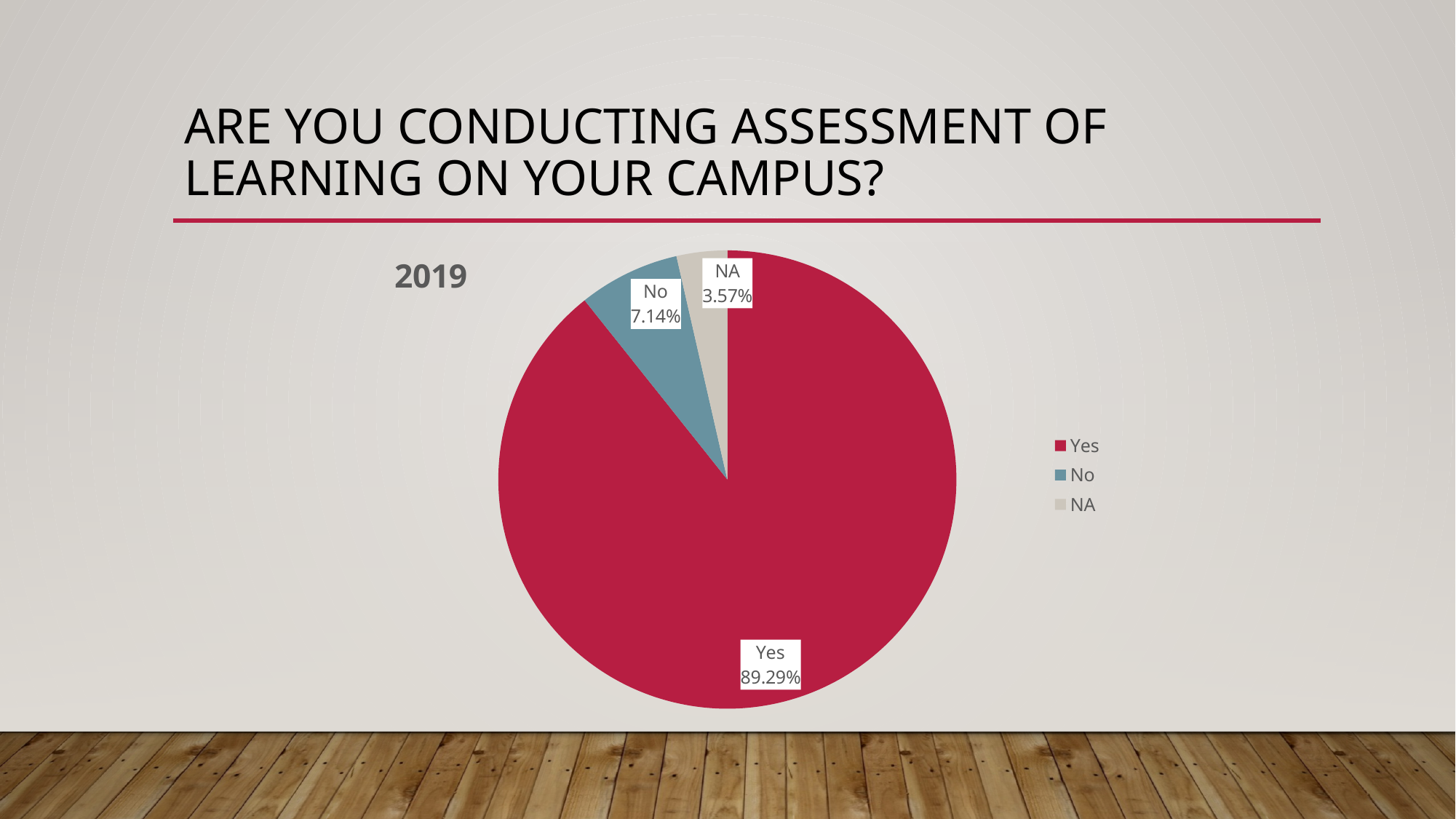
What share of the pie is labelled NA? 3.57% Which slice of the pie is the largest? Yes Which is larger, the No slice or the NA slice? No Which slice of the pie is the smallest? NA What share of the pie is labelled Yes? 89.29% How many slices does the pie chart have? 3 How many entries does the legend list? 3 What year is shown as the chart's title? 2019 What share of the pie is labelled No? 7.14% What kind of chart is shown on the slide? pie chart What is the difference in percentage points between the No slice and the NA slice? 3.57 What is the difference in percentage points between the Yes slice and the No slice? 82.15